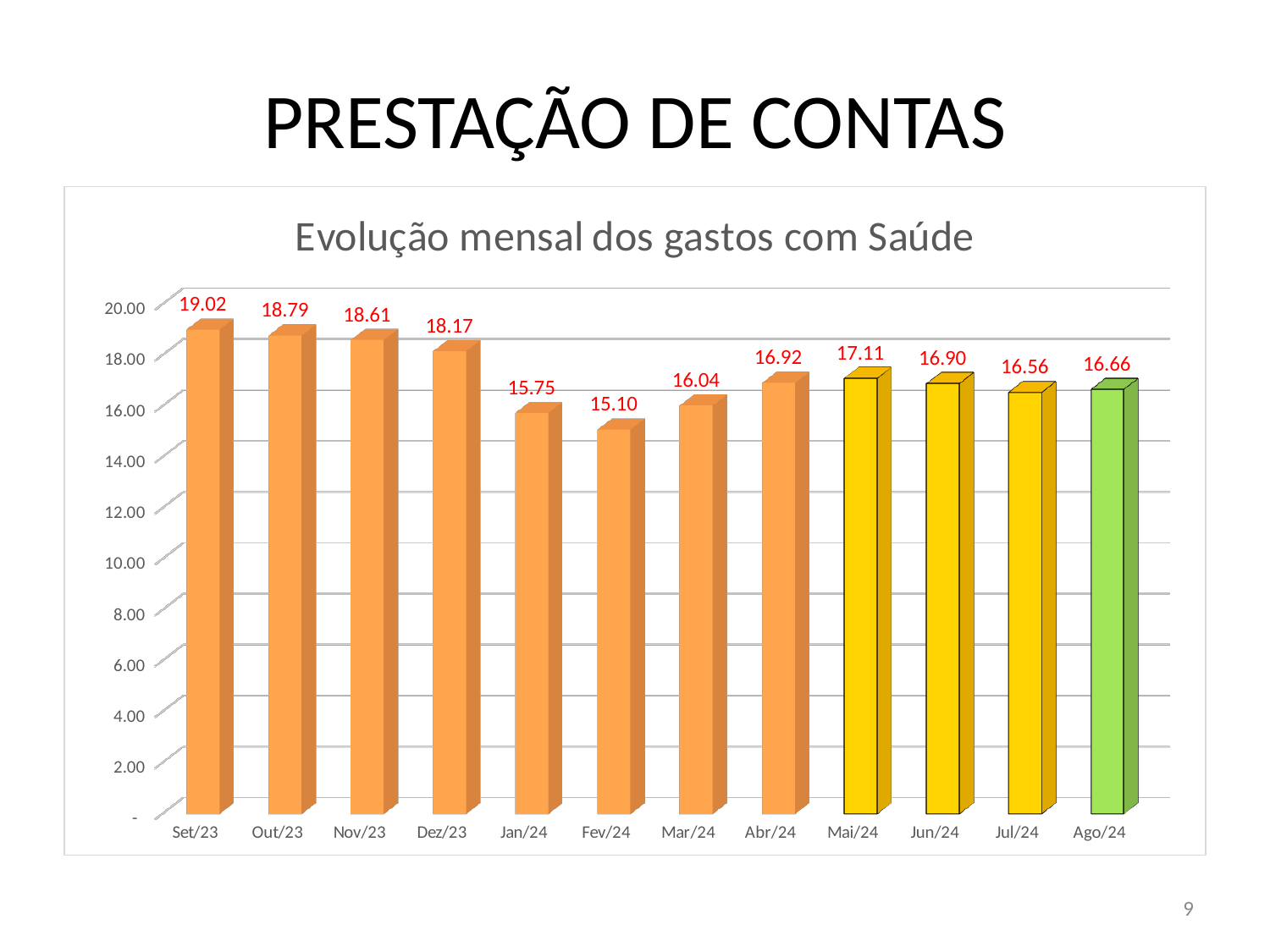
What is the value for Set/23? 19.02 Is the value for Jan/24 greater or less than 16.00? less How many months are shown on the x axis? 12 What is the title of the chart? Evolução mensal dos gastos com Saúde Which month has the lowest value? Fev/24 Which month has the highest value? Set/23 What is the value for Ago/24? 16.66 Which is larger, the value for Dez/23 or the value for Abr/24? Dez/23 What kind of chart is shown? bar chart What is the value for Fev/24? 15.10 What is the difference between the values for Mai/24 and Jun/24? 0.21 What is the difference between the values for Set/23 and Fev/24? 3.92